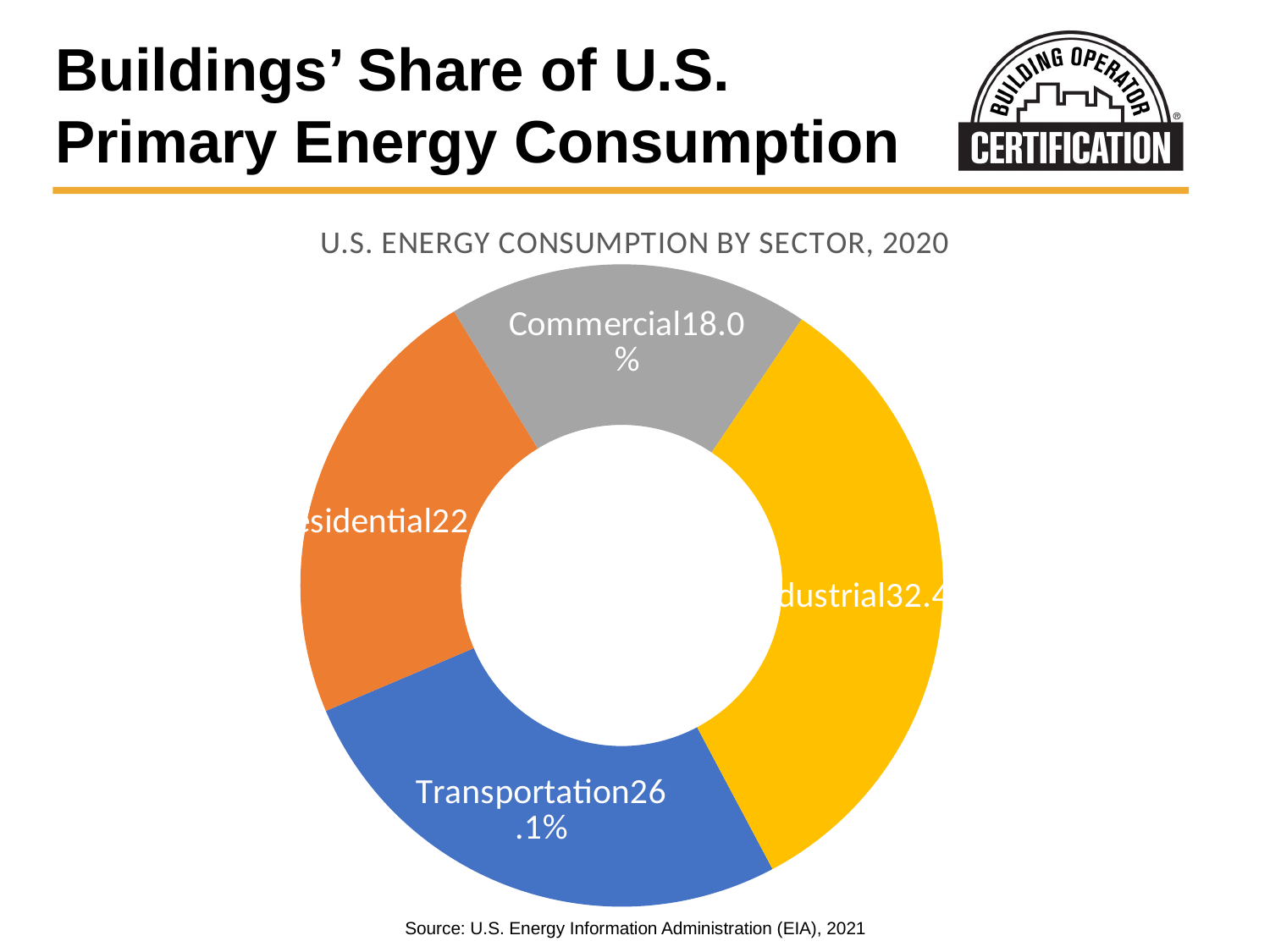
Which sector has the smallest share of U.S. energy consumption? Commercial Which sector has a larger share, Industrial or Residential? Industrial What share of U.S. energy consumption does the Commercial sector have? 18.0% What share of U.S. energy consumption does the Transportation sector have? 26.1% How many sectors are shown in the chart? 4 What is the title of the chart? U.S. ENERGY CONSUMPTION BY SECTOR, 2020 What is the difference in percentage points between the Transportation and Commercial shares? 8.1 percentage points Which sector is shown in yellow? Industrial Which sector is shown in blue? Transportation Which sector has the largest share of U.S. energy consumption? Industrial Which sector has a larger share, Transportation or Commercial? Transportation What kind of chart is shown on the slide? Doughnut (pie) chart